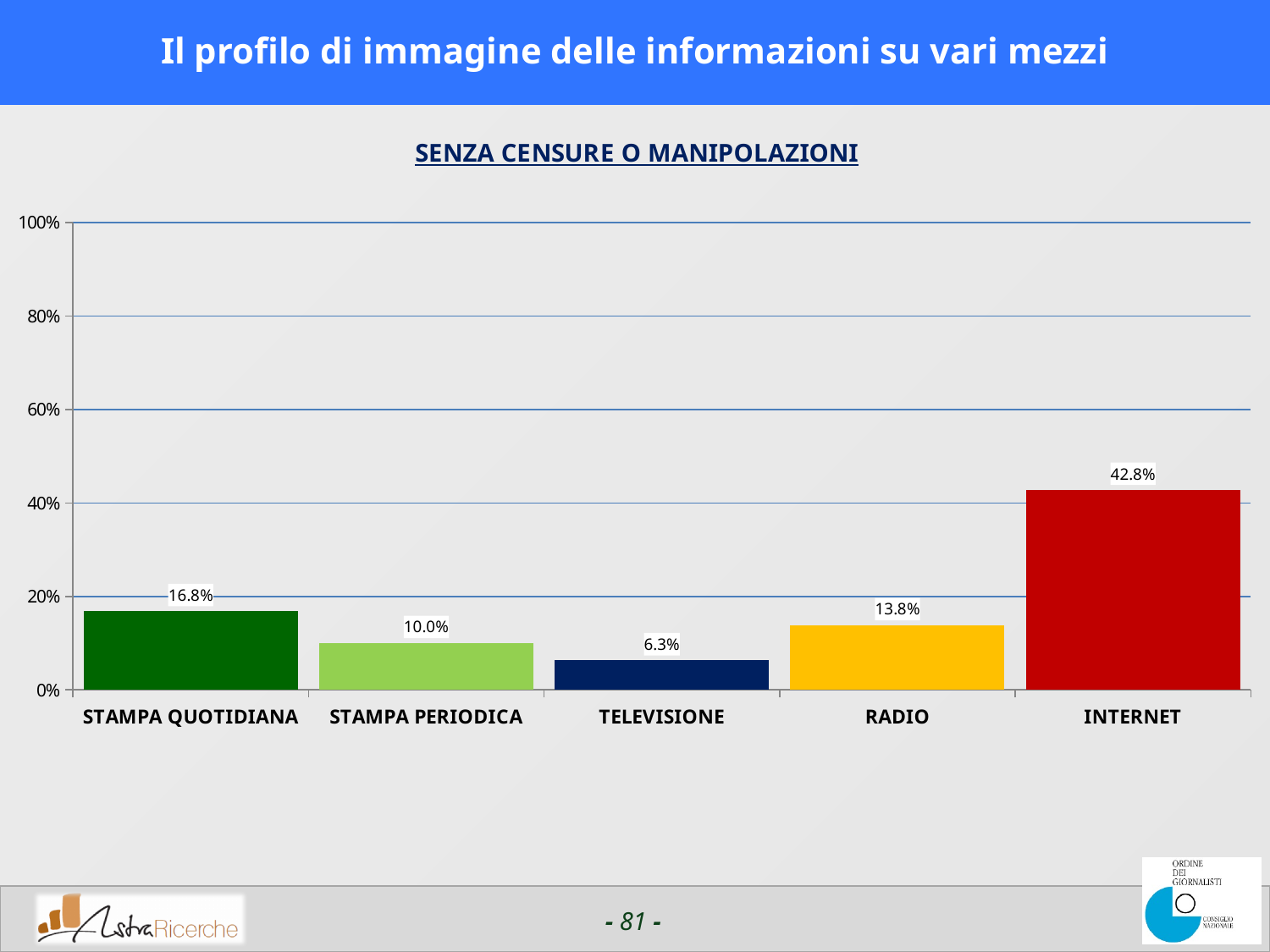
What is the value for STAMPA QUOTIDIANA? 16.8% What is the value for TELEVISIONE? 6.3% Which category has the highest value? INTERNET What is the value for RADIO? 13.8% Which category has the lowest value? TELEVISIONE Is the value for INTERNET greater or less than 40%? greater How many categories are shown on the x axis? 5 What is the title of the chart? SENZA CENSURE O MANIPOLAZIONI What kind of chart is shown on the slide? bar chart Which is larger, the value for RADIO or the value for STAMPA PERIODICA? RADIO What is the value for INTERNET? 42.8% What is the difference between the values for INTERNET and STAMPA QUOTIDIANA? 26.0%